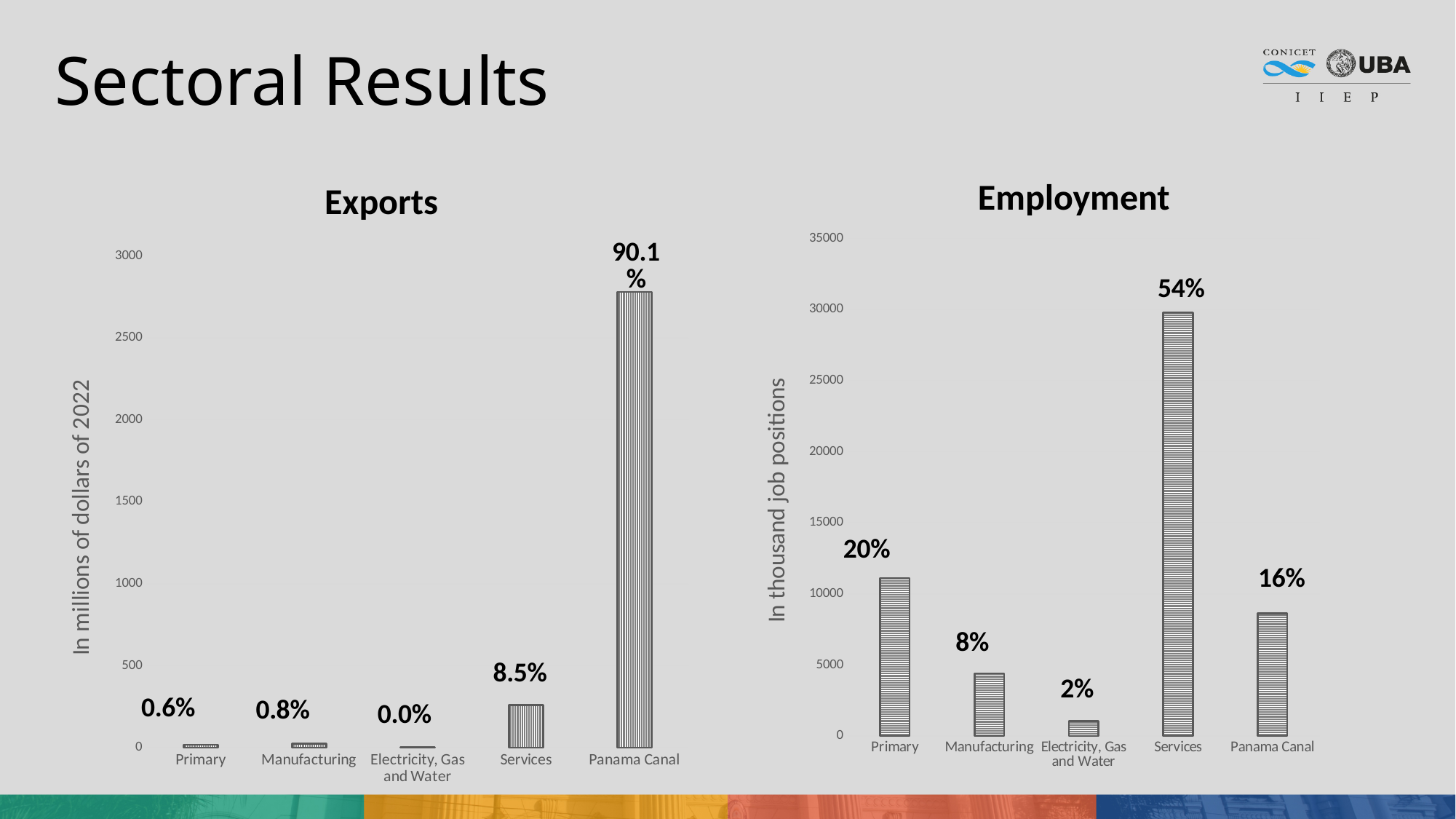
What is the y-axis label of the Exports chart? In millions of dollars of 2022 How many categories are shown on the x axis of the Employment chart? 5 In the Exports chart, what data label is shown on the Panama Canal bar? 90.1% In the Exports chart, is the value for Panama Canal greater or less than 2500? greater In the Employment chart, which category has the lowest value? Electricity, Gas and Water In the Employment chart, which category has the highest value? Services In the Employment chart, what data label is shown on the Services bar? 54% In the Exports chart, which category has the highest value? Panama Canal In the Exports chart, what data label is shown on the Services bar? 8.5% In the Employment chart, is the value for Services greater or less than 25000? greater In the Exports chart, which category has the lowest value? Electricity, Gas and Water In the Employment chart, which is larger, the value for Primary or the value for Panama Canal? Primary